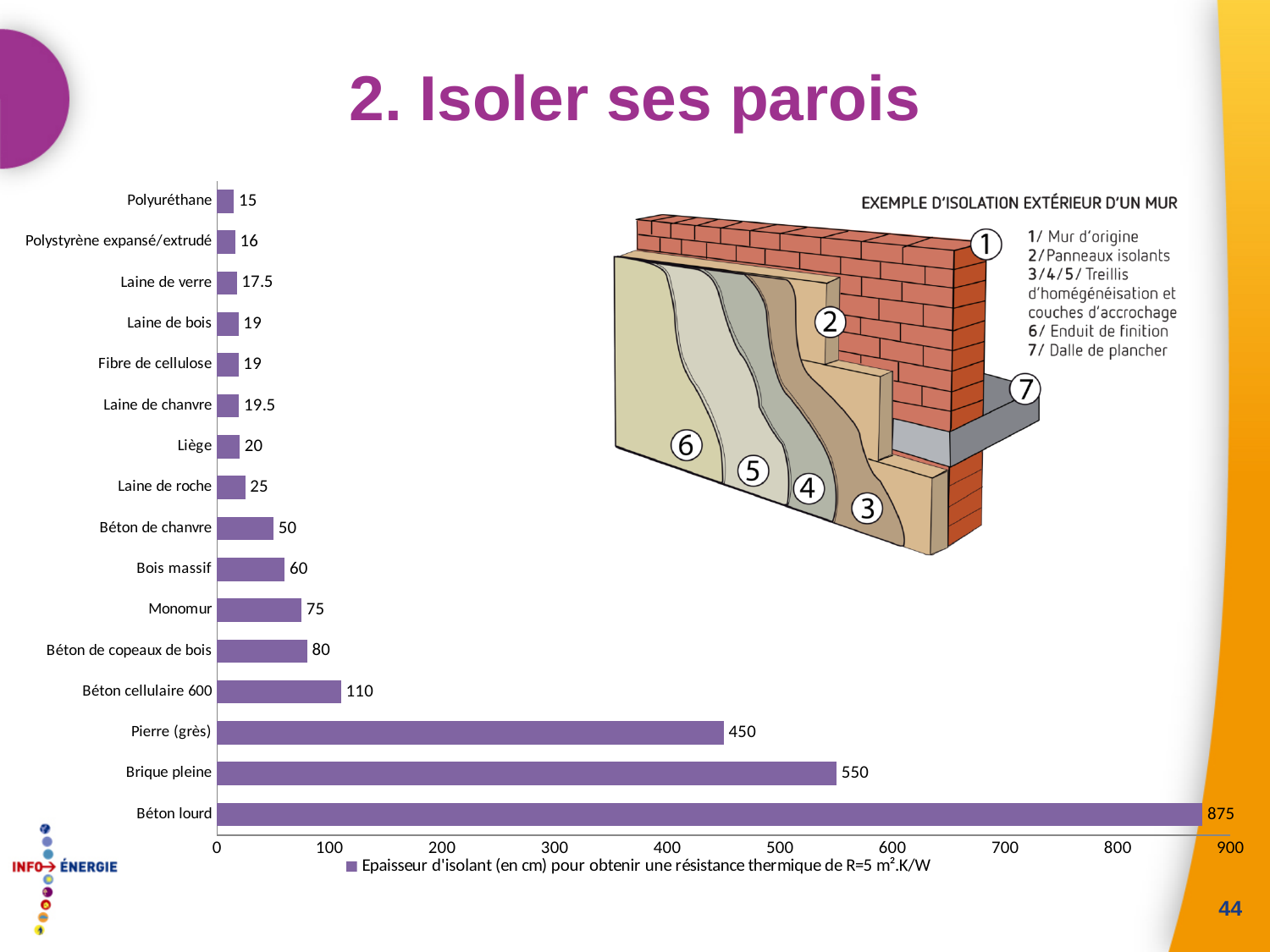
What kind of chart is shown on the slide? Bar chart What is the legend entry of the chart? Epaisseur d'isolant (en cm) pour obtenir une résistance thermique de R=5 m².K/W What is the value for Laine de verre? 17.5 Which is larger, the value for Monomur or the value for Bois massif? Monomur What is the difference between the values for Pierre (grès) and Béton cellulaire 600? 340 Which category has the highest value? Béton lourd What is the difference between the values for Béton lourd and Brique pleine? 325 How many categories are shown in the chart? 16 What is the value for Brique pleine? 550 What is the value for Béton cellulaire 600? 110 How many series does the legend list? 1 Which category has the lowest value? Polyuréthane